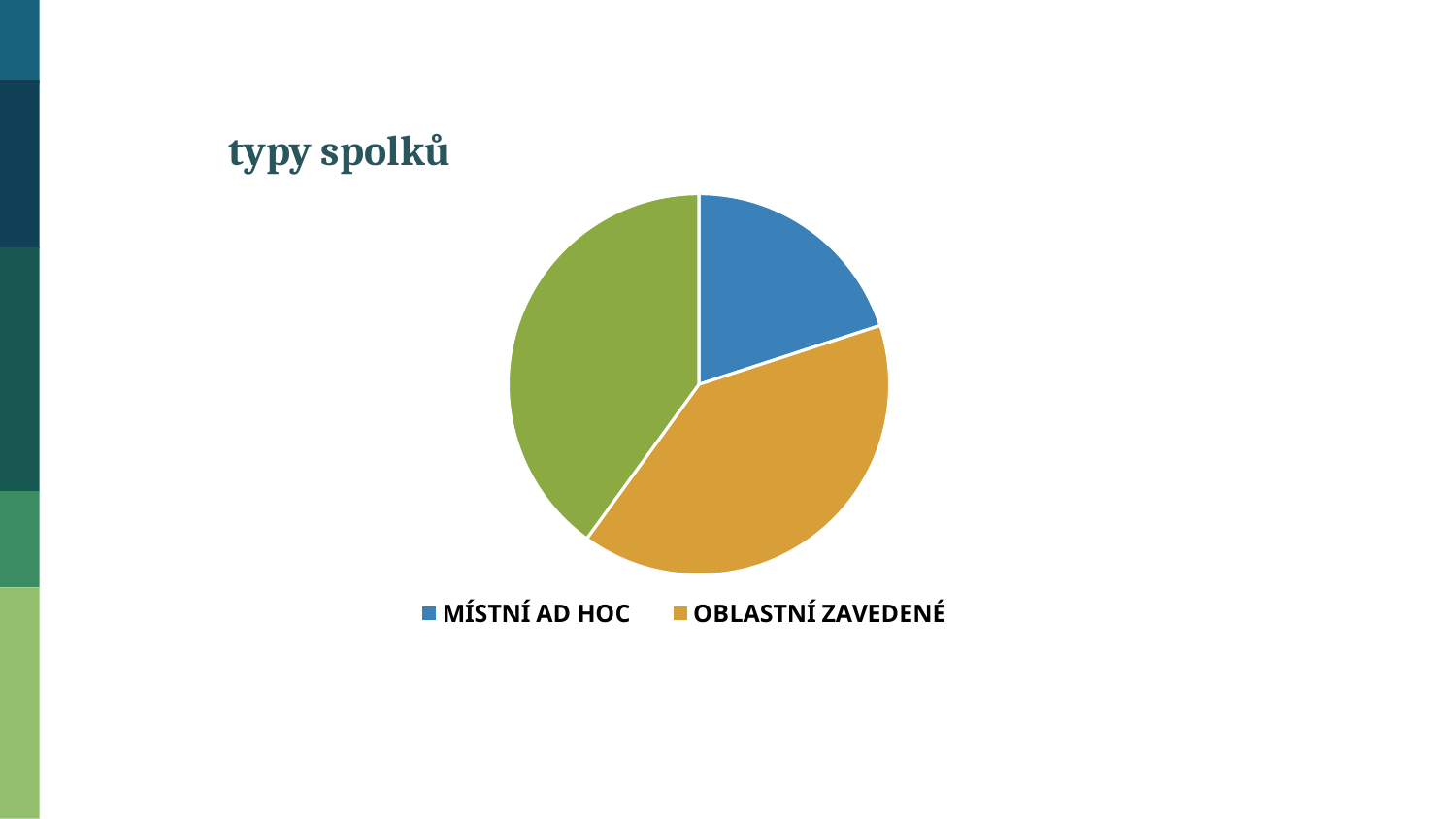
How many slices does the pie chart have? 3 Which slice is larger, MÍSTNÍ AD HOC or OBLASTNÍ ZAVEDENÉ? OBLASTNÍ ZAVEDENÉ What kind of chart is shown on the slide? pie chart What is the title of the chart? typy spolků Which legend category has the smallest slice of the pie? MÍSTNÍ AD HOC How many entries does the chart's legend list? 2 What colour is the MÍSTNÍ AD HOC slice in the pie chart? blue